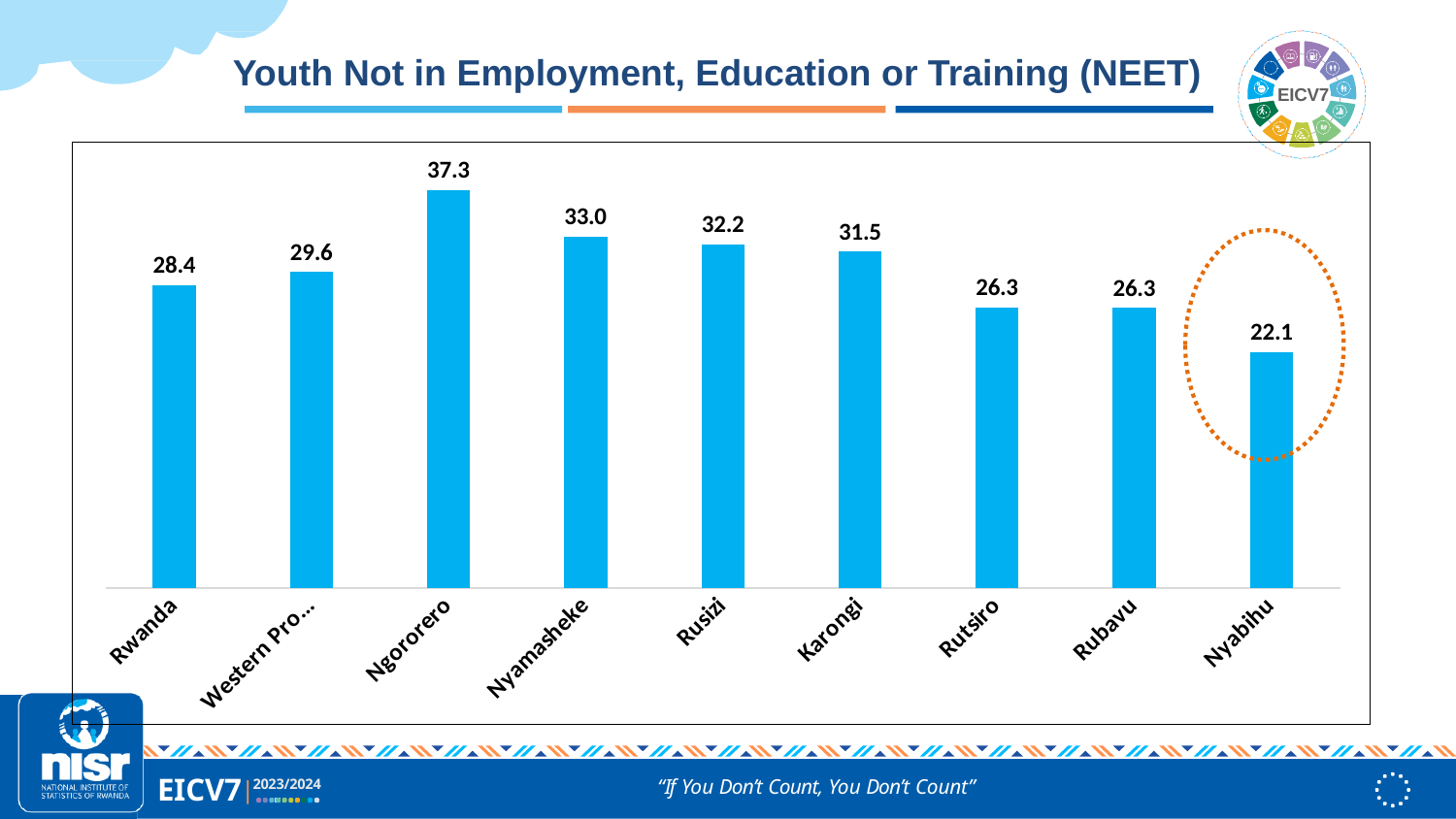
What is the difference between the NEET values for Nyamasheke and Rusizi? 0.8 What is the NEET value for Ngororero? 37.3 What kind of chart is shown on the slide? Bar chart What is the difference between the NEET values for Ngororero and Nyabihu? 15.2 What is the NEET value for Nyabihu? 22.1 What is the NEET value for Karongi? 31.5 Which category on the chart is highlighted with a dotted orange circle? Nyabihu Which has a higher NEET value, Rusizi or Rutsiro? Rusizi Which category has the lowest NEET value? Nyabihu Which category has the highest NEET value? Ngororero What is the NEET value for Rwanda? 28.4 How many categories are shown on the chart? 9